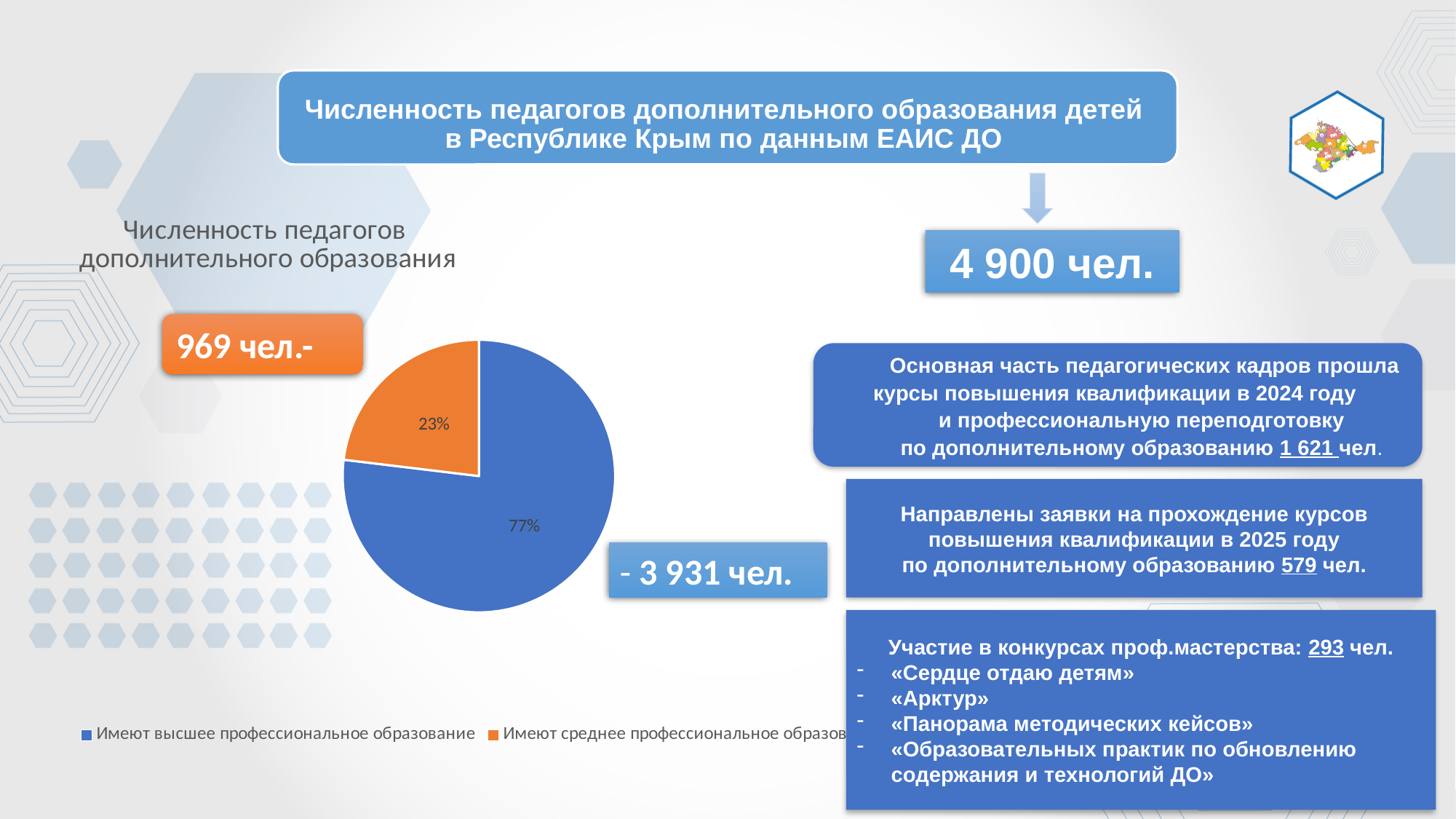
What is the total of the two percentage labels shown on the pie chart? 100% Is the share for the orange slice greater or less than 50%? less What is the difference in percentage points between the 77% slice and the 23% slice? 54 Which slice of the pie chart is the smallest? Имеют среднее профессиональное образование Which is larger: the share of teachers with higher professional education or the share with secondary professional education? Higher professional education (77%) Which slice of the pie chart is the largest? Имеют высшее профессиональное образование What colour is the slice for 'Имеют высшее профессиональное образование'? Blue What is the title of the pie chart? Численность педагогов дополнительного образования What share of the pie is shown for the orange slice? 23% What kind of chart is shown on the slide? Pie chart What share of the pie is labelled for the slice 'Имеют высшее профессиональное образование'? 77% How many slices does the pie chart have? 2